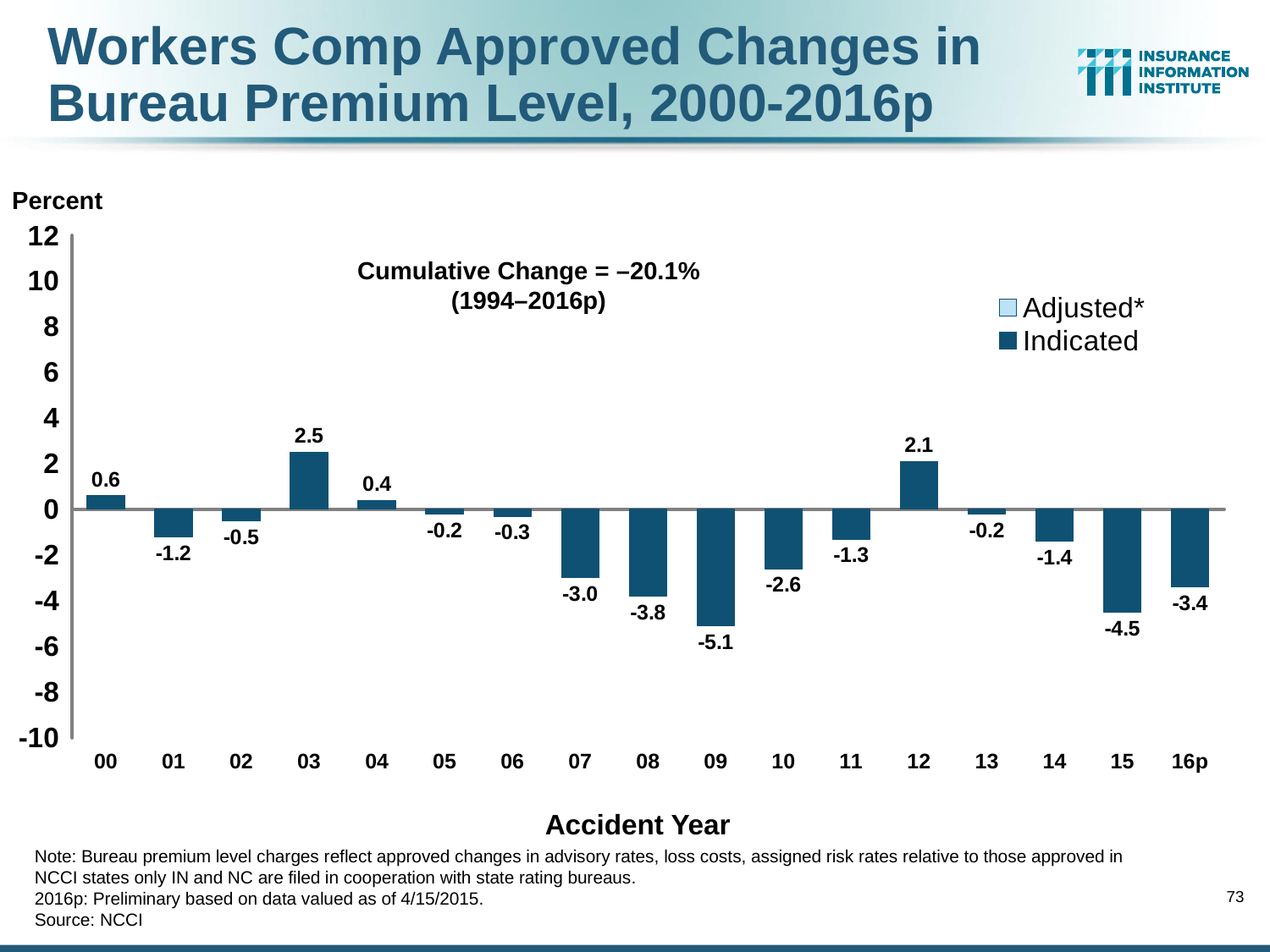
What is the value for accident year 16p? -3.4 Is the value for accident year 15 greater or less than -4? less Which accident year has the lowest value? 09 What is the difference between the values for accident years 03 and 12? 0.4 Which accident year has the highest value? 03 How many series does the legend list? 2 What kind of chart is shown on the slide? bar chart What is the value for accident year 03? 2.5 Which is larger, the value for accident year 08 or accident year 15? 08 What is the value for accident year 09? -5.1 What cumulative change is stated on the chart for 1994–2016p? –20.1% How many accident years are shown on the x axis? 17